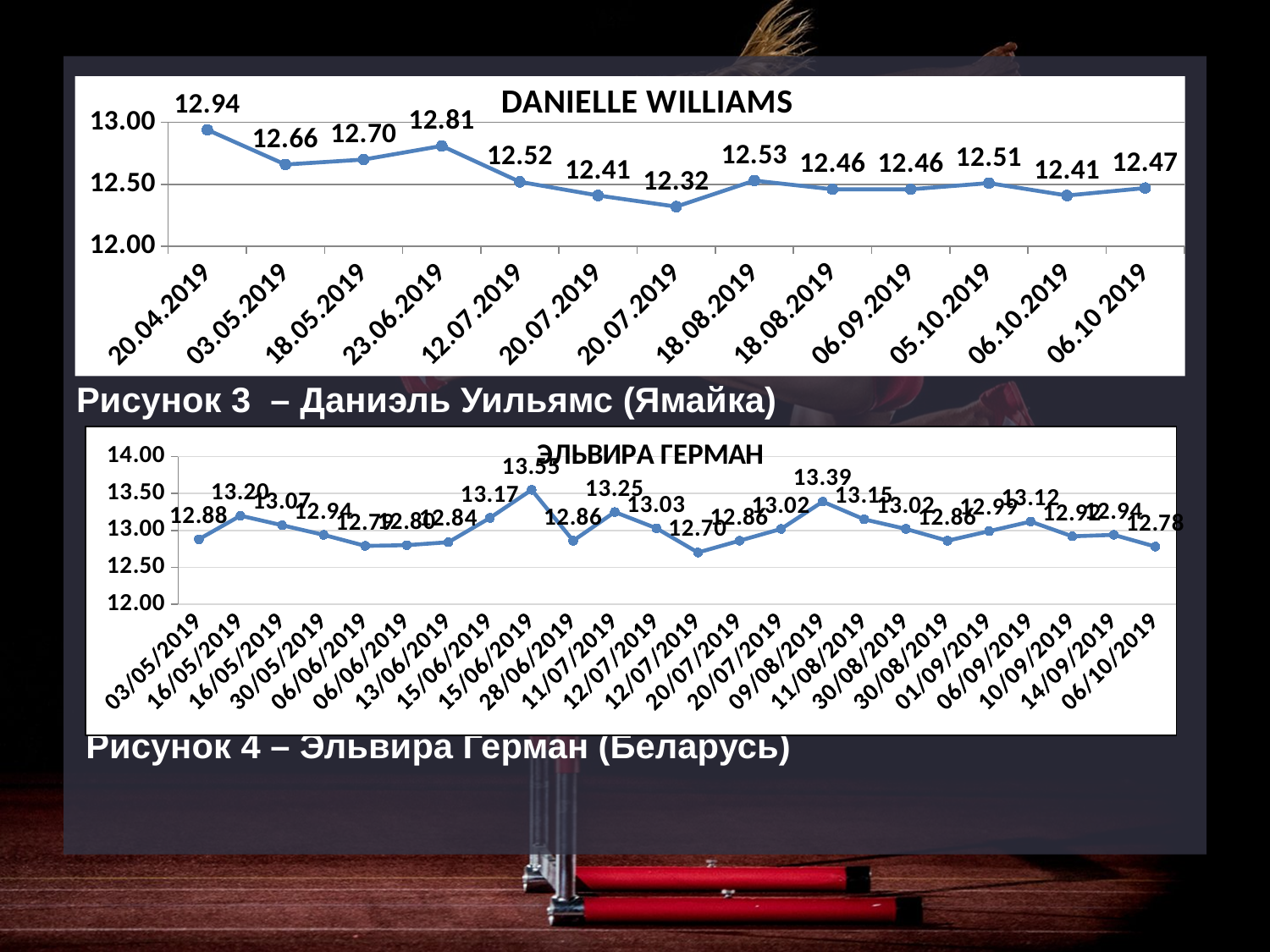
In the ЭЛЬВИРА ГЕРМАН chart, what is the difference between the values for 06/09/2019 and 10/09/2019? 0.20 In the DANIELLE WILLIAMS chart, which is larger: the value for 18.05.2019 or the value for 05.10.2019? 18.05.2019 In the DANIELLE WILLIAMS chart, what is the difference between the values for 03.05.2019 and 23.06.2019? 0.15 In the ЭЛЬВИРА ГЕРМАН chart, is the value for 11/07/2019 greater or less than 13.00? greater What type of chart is the DANIELLE WILLIAMS chart? Line chart In the DANIELLE WILLIAMS chart, what is the value for 20.04.2019? 12.94 In the ЭЛЬВИРА ГЕРМАН chart, what is the value for 06/10/2019? 12.78 In the DANIELLE WILLIAMS chart, what is the lowest value plotted? 12.32 How many data points are plotted in the DANIELLE WILLIAMS chart? 13 In the DANIELLE WILLIAMS chart, what is the value for 12.07.2019? 12.52 In the ЭЛЬВИРА ГЕРМАН chart, what is the highest value plotted? 13.55 In the ЭЛЬВИРА ГЕРМАН chart, what is the value for 09/08/2019? 13.39